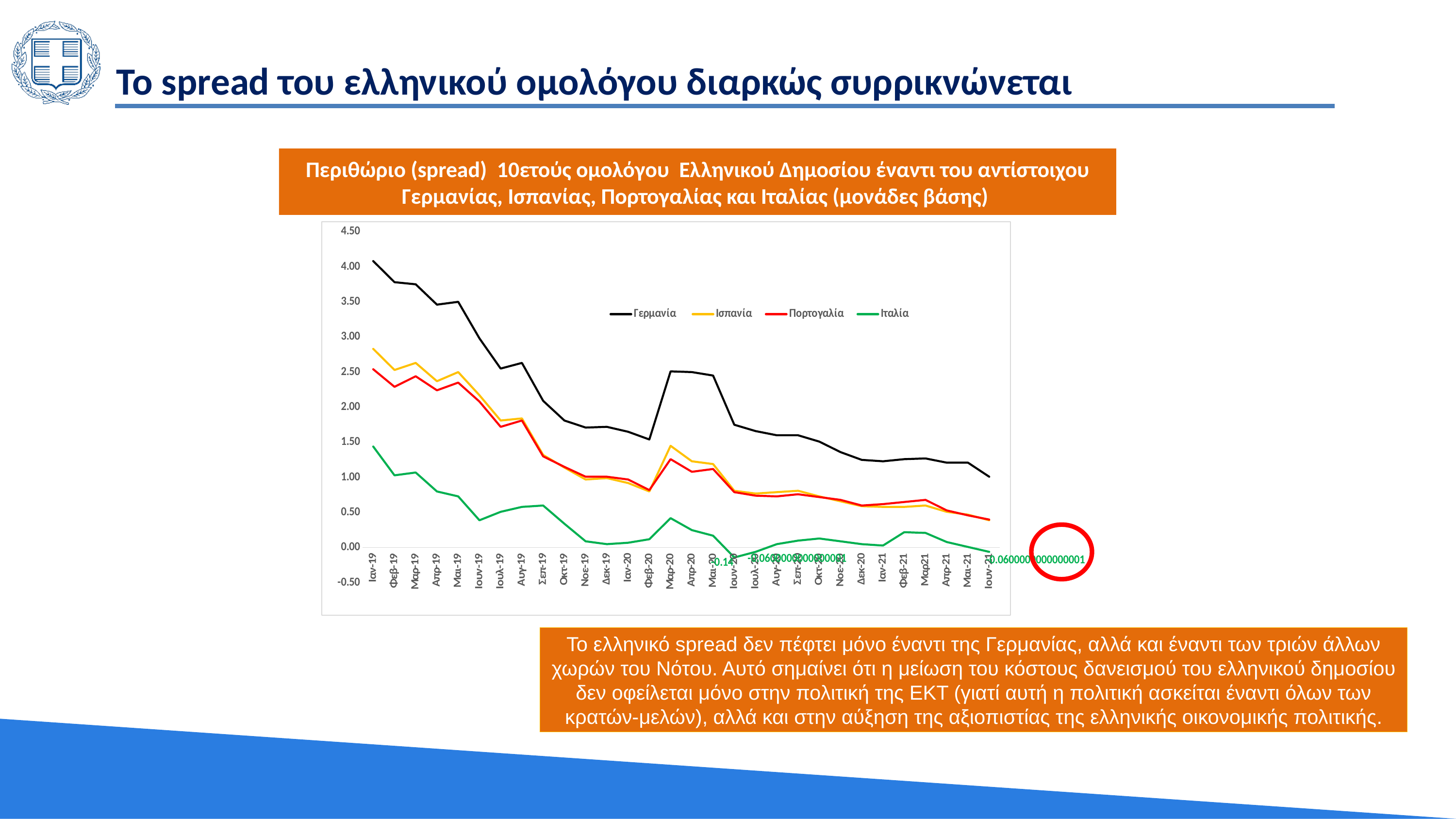
Which series has the lowest value at Ιαν-19? Ιταλία What colour is the Ιταλία line in the chart? green What colour is the Γερμανία line in the chart? black Is the value for Ιταλία at Ιαν-19 greater or less than 1.00? greater How many monthly points are plotted along the x axis, from Ιαν-19 to Ιουν-21? 30 How many series does the chart legend list? 4 Which series has the highest value at Ιαν-19? Γερμανία What kind of chart is shown on the slide? line chart Is the value for Γερμανία at Μαρ-20 greater or less than 2.00? greater Does the Γερμανία line overall rise or fall from Ιαν-19 to Ιουν-21? fall Is the value for Γερμανία at Ιαν-19 greater or less than 3.50? greater At Ιαν-19, which is larger: the value for Γερμανία or the value for Ιταλία? Γερμανία